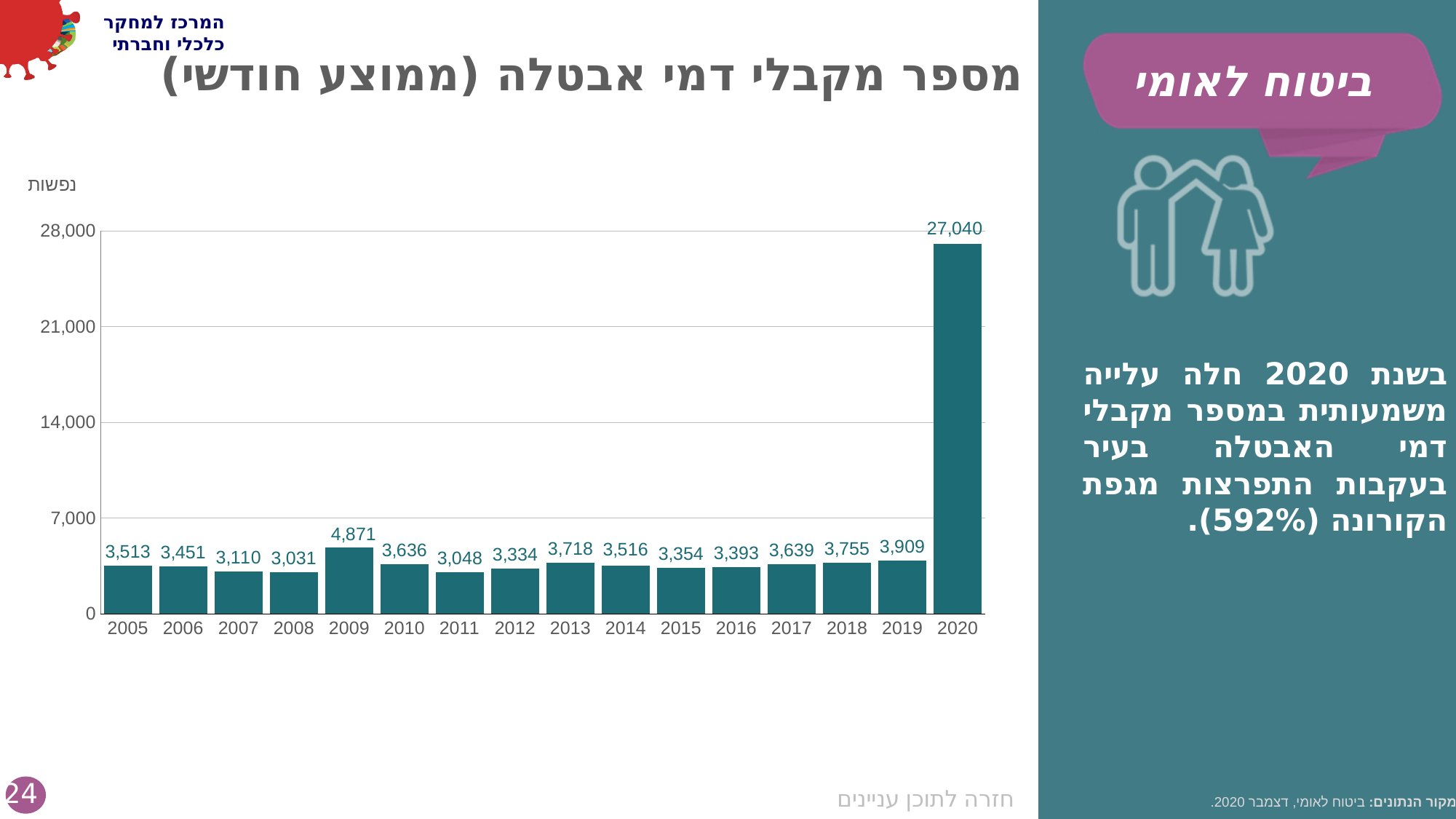
Which year has the lowest value? 2008 What is the value for 2020? 27,040 What is the unit label shown above the y axis? נפשות What is the difference between the values for 2020 and 2019? 23,131 Which year has the highest value? 2020 What kind of chart is shown on the slide? bar chart What is the value for 2009? 4,871 Is the value for 2020 greater or less than 21,000? greater What is the value for 2015? 3,354 How many years are shown on the x axis? 16 What is the difference between the values for 2009 and 2008? 1,840 Which is larger, the value for 2013 or the value for 2012? 2013